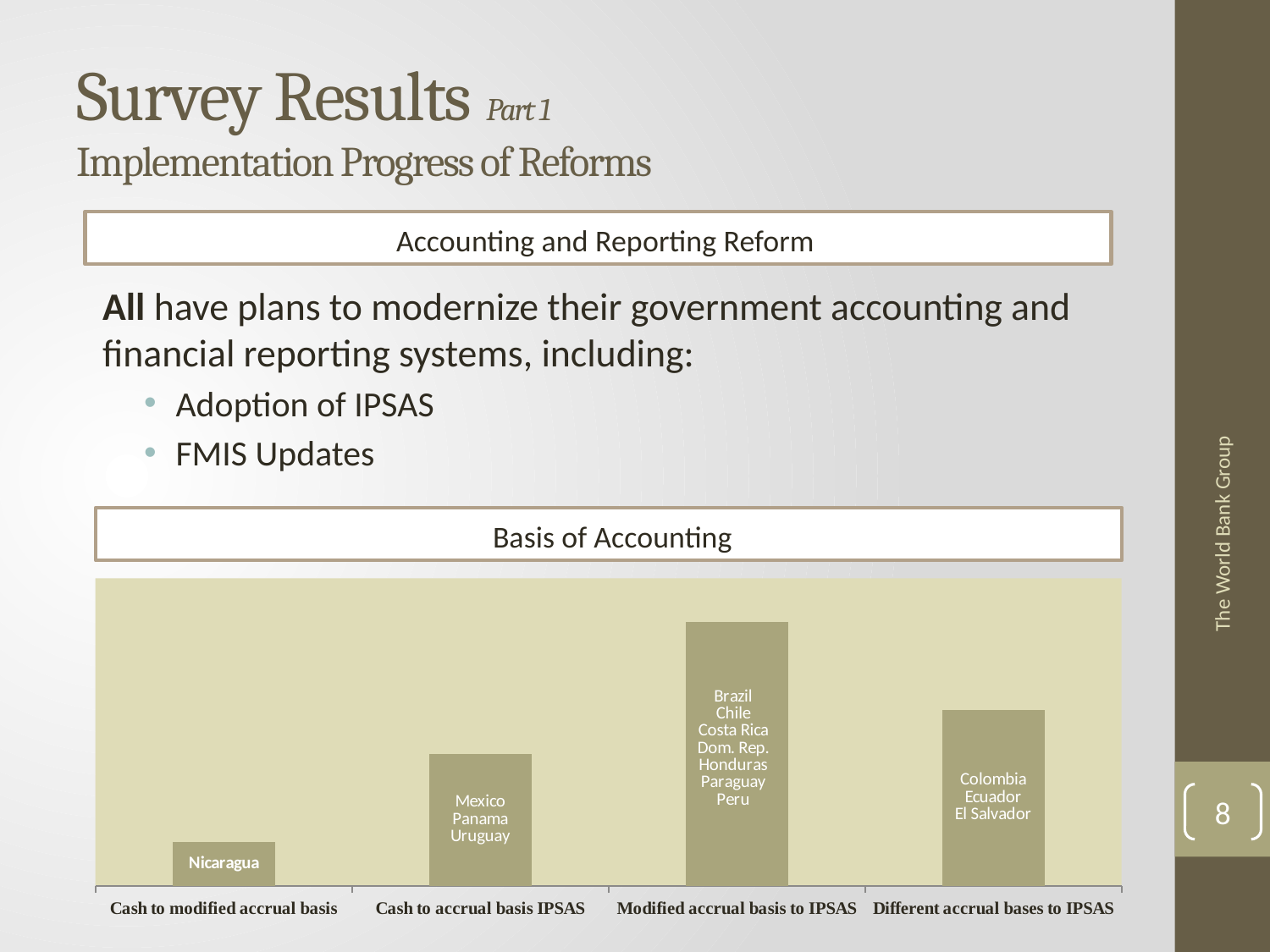
What is the title shown above the bar chart? Basis of Accounting How many countries are listed in the "Modified accrual basis to IPSAS" bar? 7 Which category in the Basis of Accounting chart has the tallest bar? Modified accrual basis to IPSAS Which countries are listed in the "Cash to accrual basis IPSAS" bar? Mexico, Panama, Uruguay Which countries are listed in the "Different accrual bases to IPSAS" bar? Colombia, Ecuador, El Salvador What kind of chart is shown under the "Basis of Accounting" heading? bar chart Is the bar for "Modified accrual basis to IPSAS" taller or shorter than the bar for "Cash to modified accrual basis"? taller How many categories are shown on the x axis of the Basis of Accounting chart? 4 Which bar in the Basis of Accounting chart includes Honduras? Modified accrual basis to IPSAS Which category in the Basis of Accounting chart has the shortest bar? Cash to modified accrual basis Which country is listed in the "Cash to modified accrual basis" bar? Nicaragua Is the bar for "Cash to accrual basis IPSAS" taller or shorter than the bar for "Modified accrual basis to IPSAS"? shorter